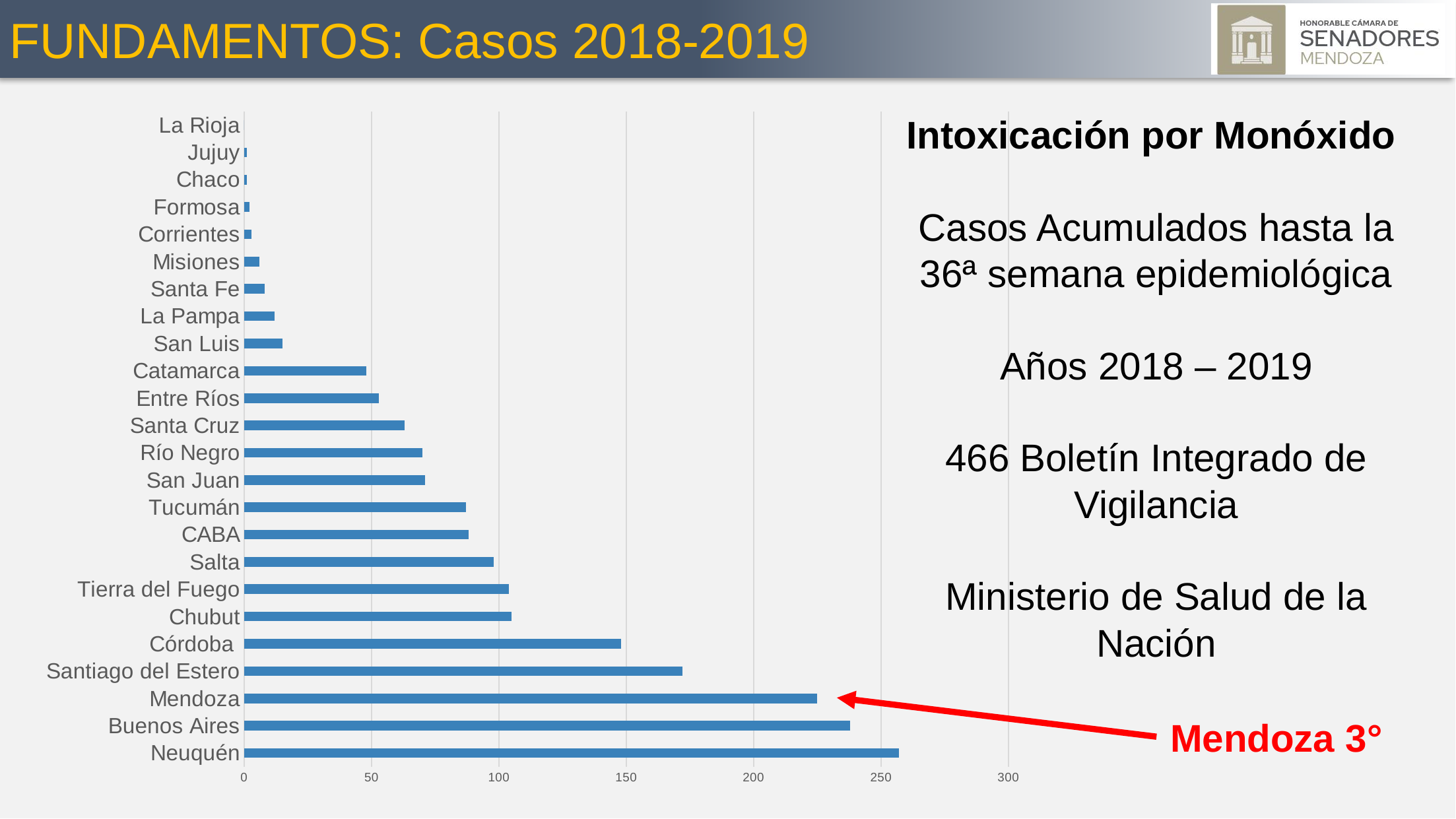
Is the value for Santiago del Estero greater or less than 200? less Is the value for Córdoba greater or less than 100? greater What kind of chart is shown on the slide? bar chart Do the bar values increase or decrease going from the top of the chart to the bottom? increase Is the value for Buenos Aires greater or less than 250? less How many provinces are listed on the chart? 24 Which province's bar does the red arrow on the slide point to? Mendoza Which has more cases, Mendoza or Santiago del Estero? Mendoza Which province has the lowest number of cases on the chart? La Rioja Which province has the highest number of cases on the chart? Neuquén